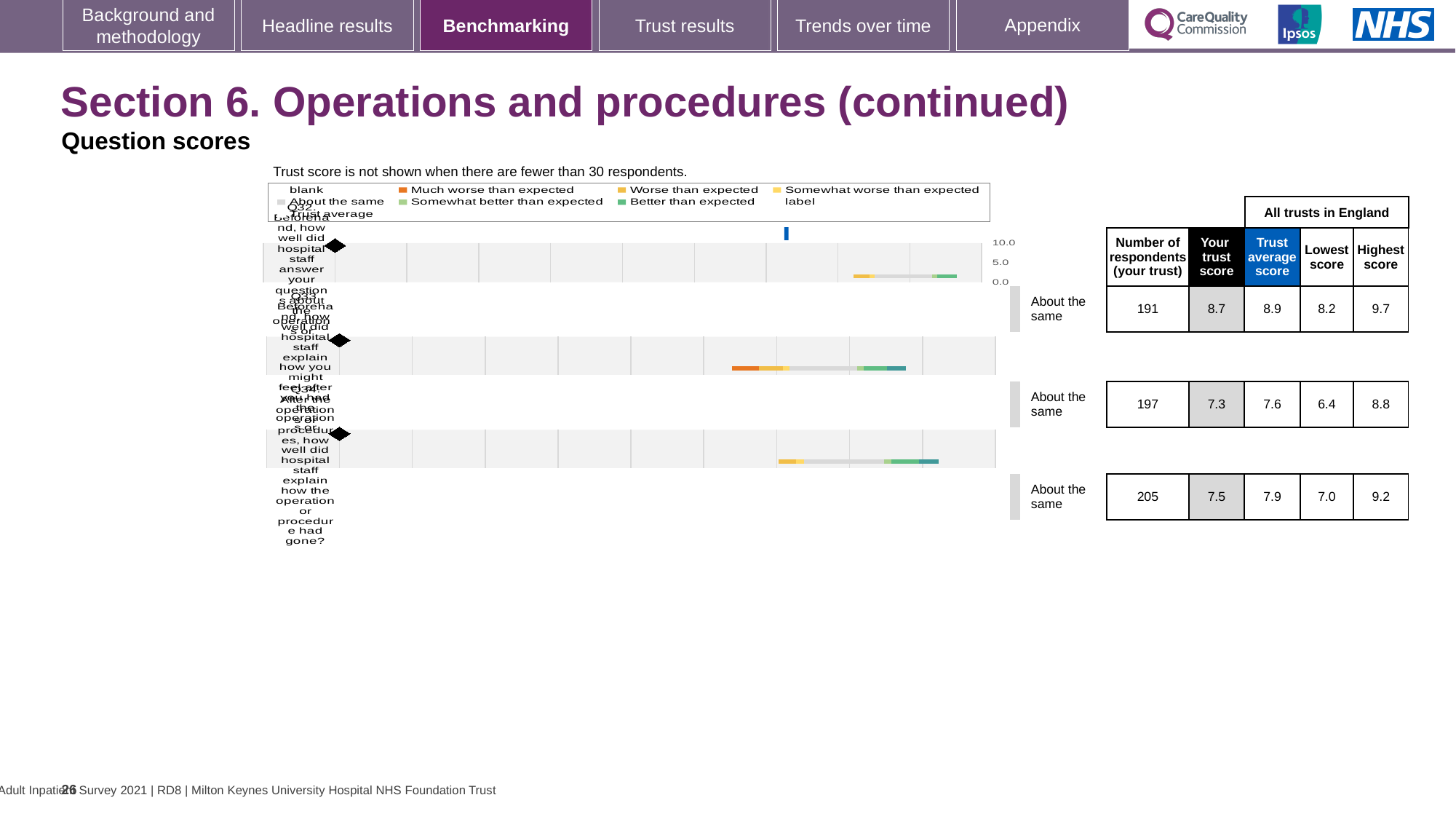
In the table next to the chart, what is the number of respondents for the first (top) question row? 191 For the third question row (205 respondents), what is the difference between the highest score and the lowest score? 2.2 What benchmark category is shown for all three questions on this slide? About the same For the third question row (205 respondents), which is larger: your trust score or the trust average score? trust average score What is the 'Highest score' for the third question row (205 respondents)? 9.2 For the first (top) question row, what is the difference between the trust average score and your trust score? 0.2 How many questions (rows) are plotted in the benchmarking chart? 3 What is the 'Lowest score' for the second question row (197 respondents)? 6.4 What is 'Your trust score' for the first (top) question row? 8.7 What kind of chart is used to show the question scores on this slide? bar chart What is the 'Trust average score' for the second question row (197 respondents)? 7.6 Which question row has the highest 'Your trust score'? the first (top) row, 8.7